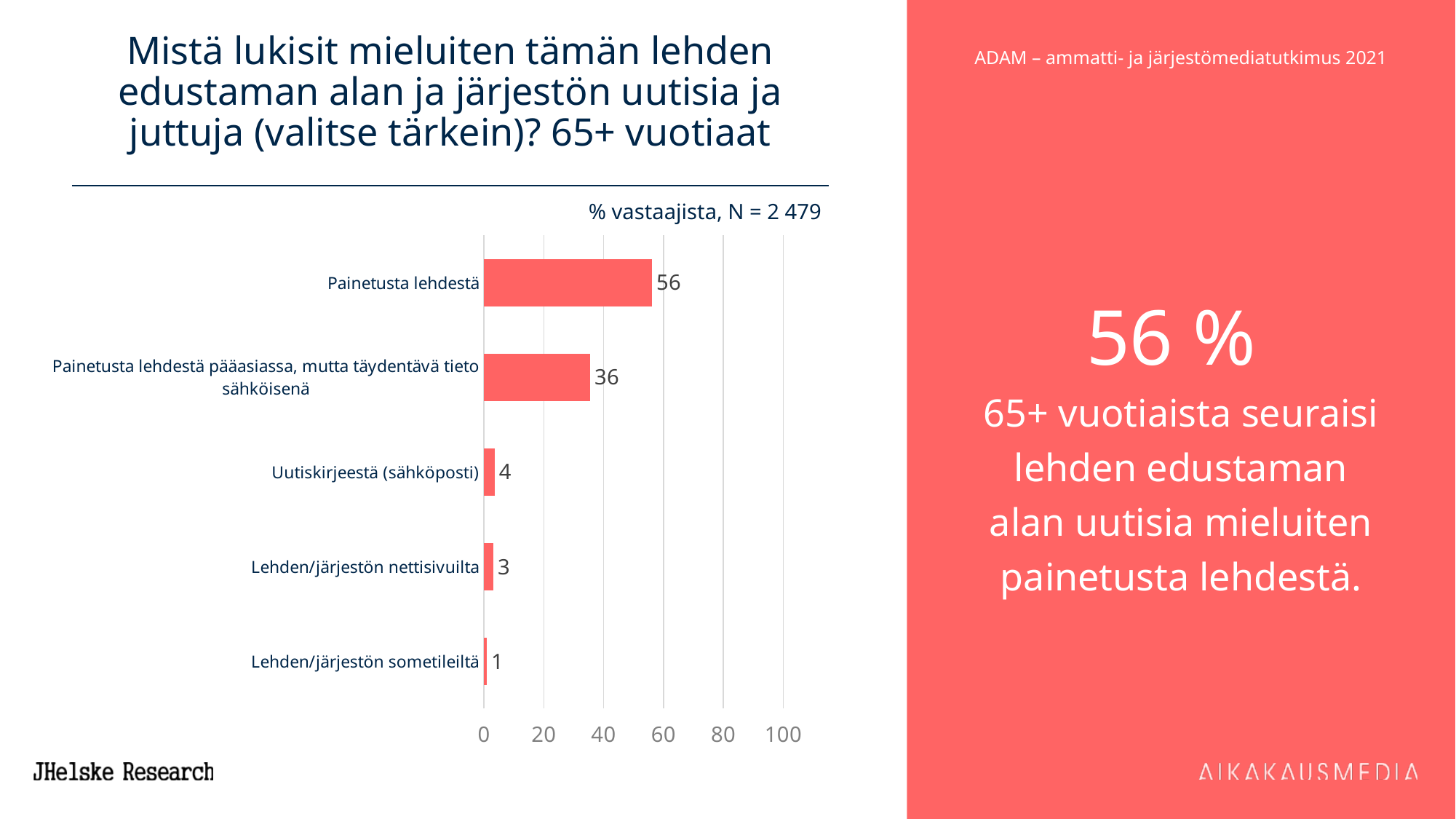
Which category has the lowest value? Lehden/järjestön sometileiltä What is the value for "Painetusta lehdestä"? 56 What is the sample size (N) stated above the chart? 2 479 Which category has the highest value? Painetusta lehdestä How many categories are shown in the chart? 5 Which is larger: the value for "Uutiskirjeestä (sähköposti)" or for "Lehden/järjestön nettisivuilta"? Uutiskirjeestä (sähköposti) What is the difference between the values for "Painetusta lehdestä" and "Painetusta lehdestä pääasiassa, mutta täydentävä tieto sähköisenä"? 20 What is the value for "Uutiskirjeestä (sähköposti)"? 4 What kind of chart is shown on the slide? bar chart Is the value for "Painetusta lehdestä" greater or less than 40? greater What is the value for "Lehden/järjestön nettisivuilta"? 3 What is the value for "Painetusta lehdestä pääasiassa, mutta täydentävä tieto sähköisenä"? 36